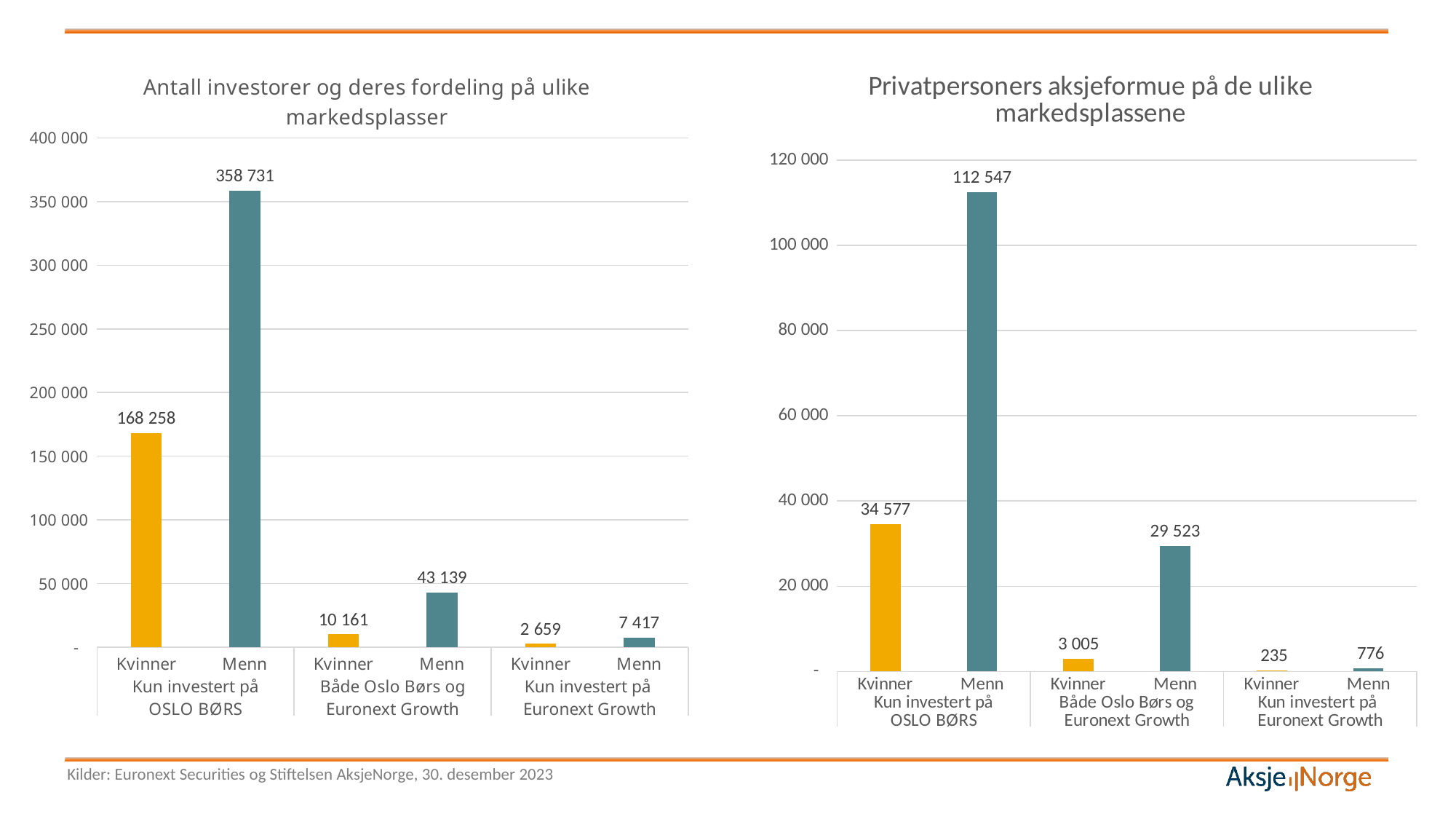
In the chart 'Antall investorer og deres fordeling på ulike markedsplasser', what is the value for Menn under 'Kun investert på OSLO BØRS'? 358 731 In the chart 'Privatpersoners aksjeformue på de ulike markedsplassene', which bar is the highest? Menn, Kun investert på OSLO BØRS In the chart 'Antall investorer og deres fordeling på ulike markedsplasser', how many bars are plotted? 6 In the chart 'Antall investorer og deres fordeling på ulike markedsplasser', what is the difference between Menn and Kvinner under 'Kun investert på OSLO BØRS'? 190 473 In the chart 'Privatpersoners aksjeformue på de ulike markedsplassene', which is larger: Menn under 'Både Oslo Børs og Euronext Growth' or Kvinner under 'Kun investert på OSLO BØRS'? Kvinner under 'Kun investert på OSLO BØRS' In the chart 'Privatpersoners aksjeformue på de ulike markedsplassene', what is the difference between Menn and Kvinner under 'Både Oslo Børs og Euronext Growth'? 26 518 In the chart 'Antall investorer og deres fordeling på ulike markedsplasser', what is the value for Kvinner under 'Både Oslo Børs og Euronext Growth'? 10 161 In the chart 'Privatpersoners aksjeformue på de ulike markedsplassene', what is the value for Menn under 'Kun investert på Euronext Growth'? 776 What type of chart is 'Antall investorer og deres fordeling på ulike markedsplasser'? Bar chart In the chart 'Privatpersoners aksjeformue på de ulike markedsplassene', is the value for Menn under 'Kun investert på OSLO BØRS' greater or less than 100 000? greater In the chart 'Antall investorer og deres fordeling på ulike markedsplasser', which bar is the lowest? Kvinner, Kun investert på Euronext Growth In the chart 'Privatpersoners aksjeformue på de ulike markedsplassene', what is the value for Kvinner under 'Kun investert på OSLO BØRS'? 34 577